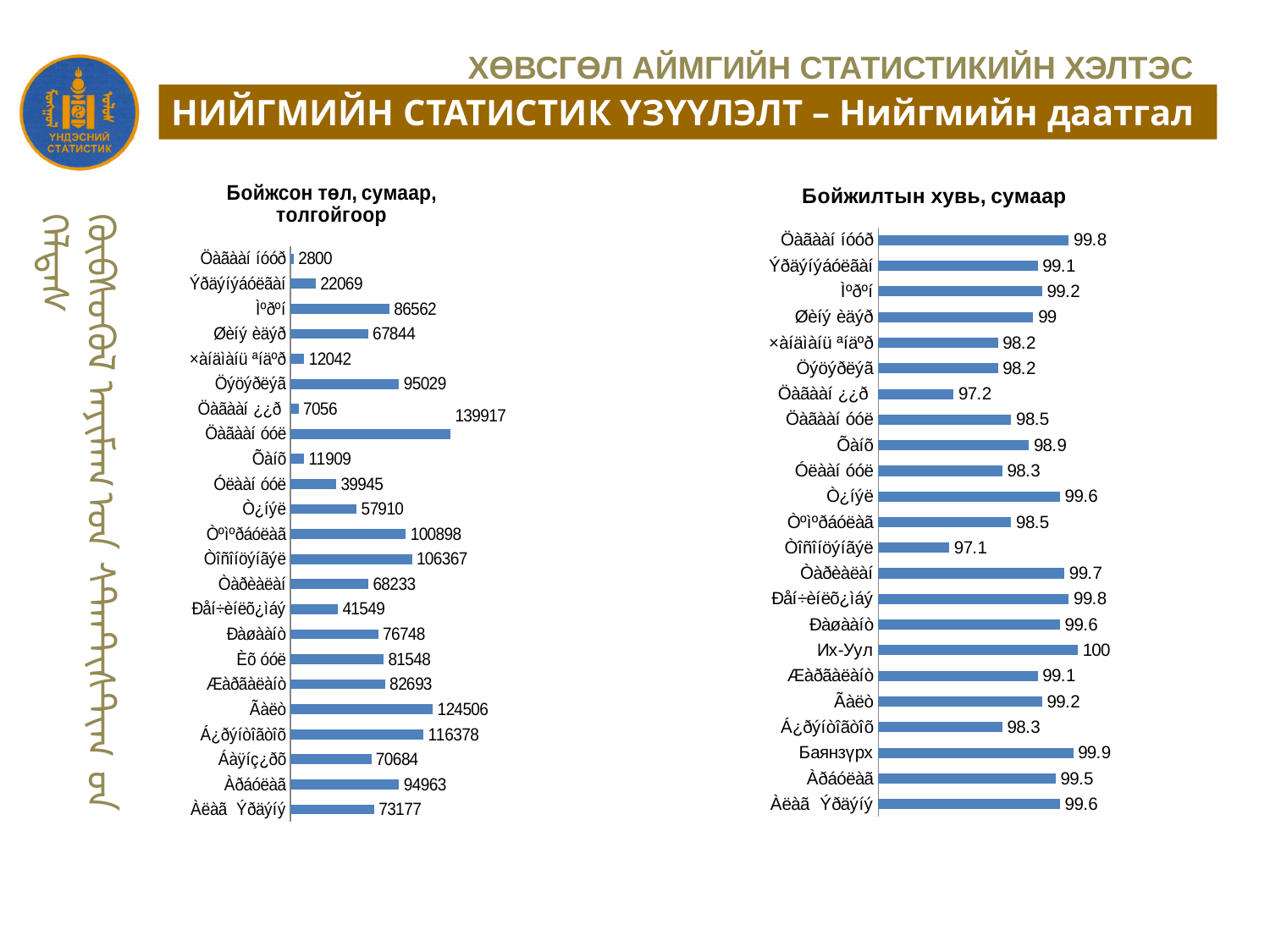
In the chart titled "Бойжсон төл, сумаар, толгойгоор", what is the lowest value shown? 2800 How many bars are shown in the chart titled "Бойжсон төл, сумаар, толгойгоор"? 23 What type of chart is the chart titled "Бойжилтын хувь, сумаар"? bar chart How many categories are shown in the chart titled "Бойжилтын хувь, сумаар"? 23 In the chart titled "Бойжсон төл, сумаар, толгойгоор", what is the highest value shown? 139917 In the chart titled "Бойжилтын хувь, сумаар", what is the value for Баянзүрх? 99.9 What is the title of the chart on the left side of the slide? Бойжсон төл, сумаар, толгойгоор In the chart titled "Бойжилтын хувь, сумаар", which category has the highest value? Их-Уул In the chart titled "Бойжилтын хувь, сумаар", what is the value for Их-Уул? 100 In the chart titled "Бойжилтын хувь, сумаар", what is the lowest value shown? 97.1 In the chart titled "Бойжилтын хувь, сумаар", what is the difference between the values for Их-Уул and Баянзүрх? 0.1 In the chart titled "Бойжилтын хувь, сумаар", which is larger, the value for Их-Уул or the value for Баянзүрх? Их-Уул